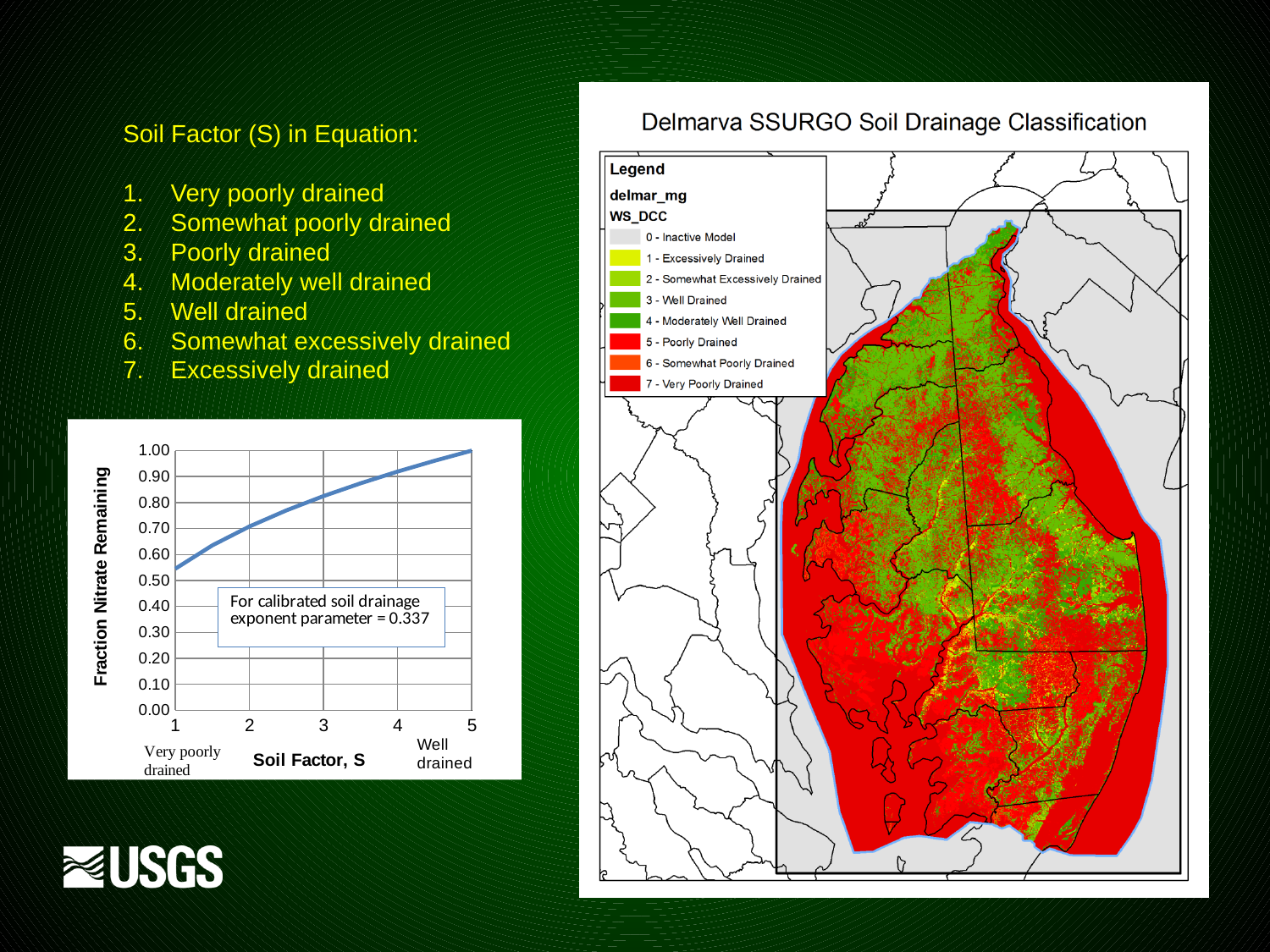
Does the fraction of nitrate remaining rise or fall as the soil factor S increases from 1 to 5? rise Is the fraction of nitrate remaining at a soil factor of 4 greater or less than 0.80? greater What kind of chart is shown on the slide? line chart What is the title of the x axis of the chart? Soil Factor, S At which soil factor value is the fraction of nitrate remaining highest? 5 At which soil factor value is the fraction of nitrate remaining lowest? 1 Which has a larger fraction of nitrate remaining, a soil factor of 2 or a soil factor of 4? 4 Is the fraction of nitrate remaining at a soil factor of 3 greater or less than 0.90? less What is the title of the y axis of the chart? Fraction Nitrate Remaining Is the fraction of nitrate remaining at a soil factor of 1 greater or less than 0.50? greater What is the fraction of nitrate remaining at a soil factor of 5? 1.00